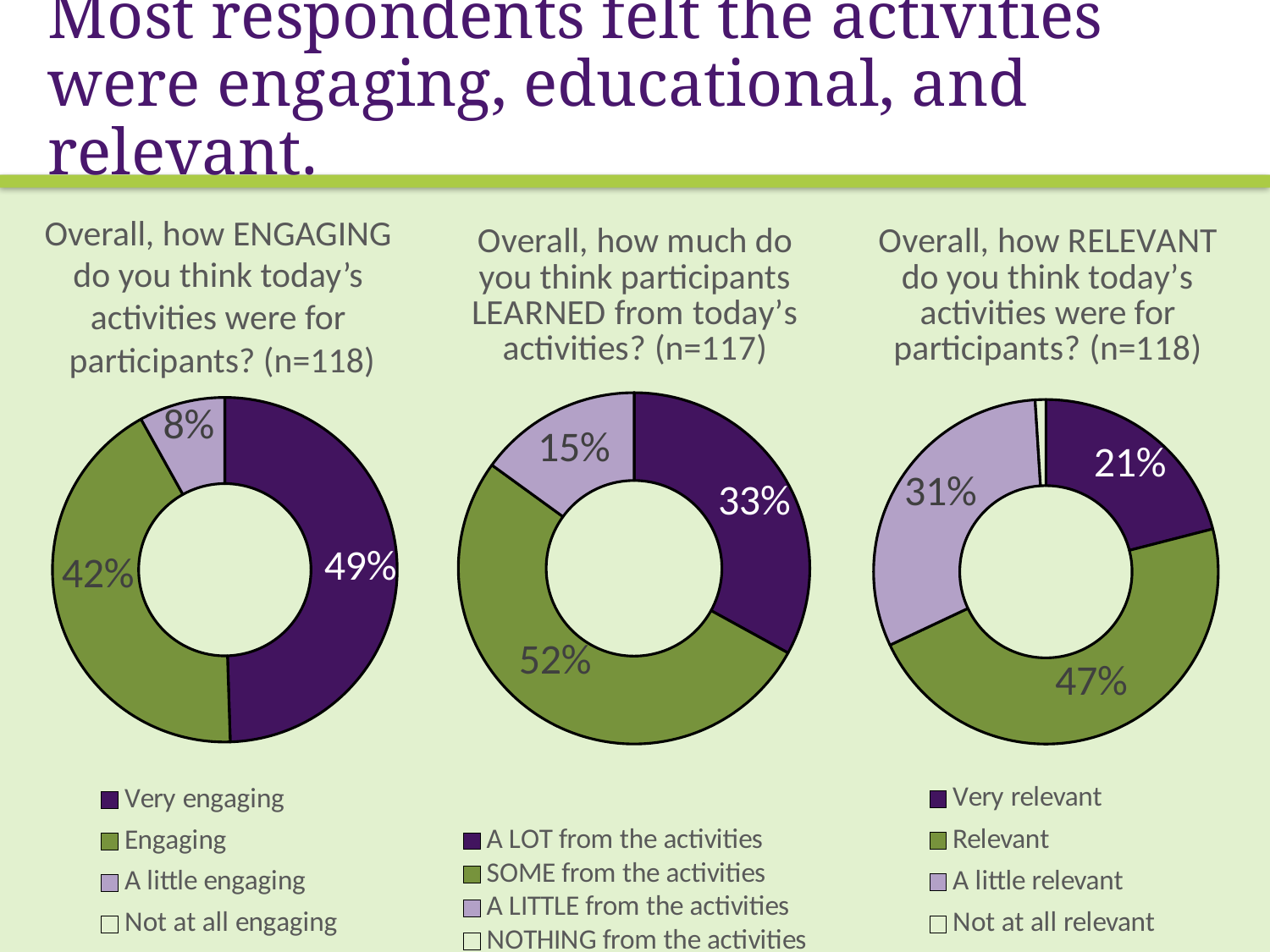
In the left chart (how ENGAGING), which labelled response category has the smallest share? A little engaging What is the sample size (n) shown in the title of the middle chart about how much participants LEARNED? n=117 In the middle chart (how much participants LEARNED), what percentage answered 'A LOT from the activities'? 33% In the left chart (how ENGAGING), what percentage answered 'A little engaging'? 8% How many entries does the legend of the middle chart (how much participants LEARNED) list? 4 In the right chart (how RELEVANT), which is larger: the share for 'Very relevant' or the share for 'A little relevant'? A little relevant In the left chart (how ENGAGING), what percentage of respondents answered 'Very engaging'? 49% In the right chart (how RELEVANT), which response category has the largest share? Relevant In the middle chart (how much participants LEARNED), what percentage answered 'SOME from the activities'? 52% What kind of chart is used for the three survey questions on this slide? Pie (donut) chart In the right chart (how RELEVANT), what percentage answered 'A little relevant'? 31% In the middle chart (how much participants LEARNED), what is the difference in percentage points between 'SOME from the activities' and 'A LOT from the activities'? 19